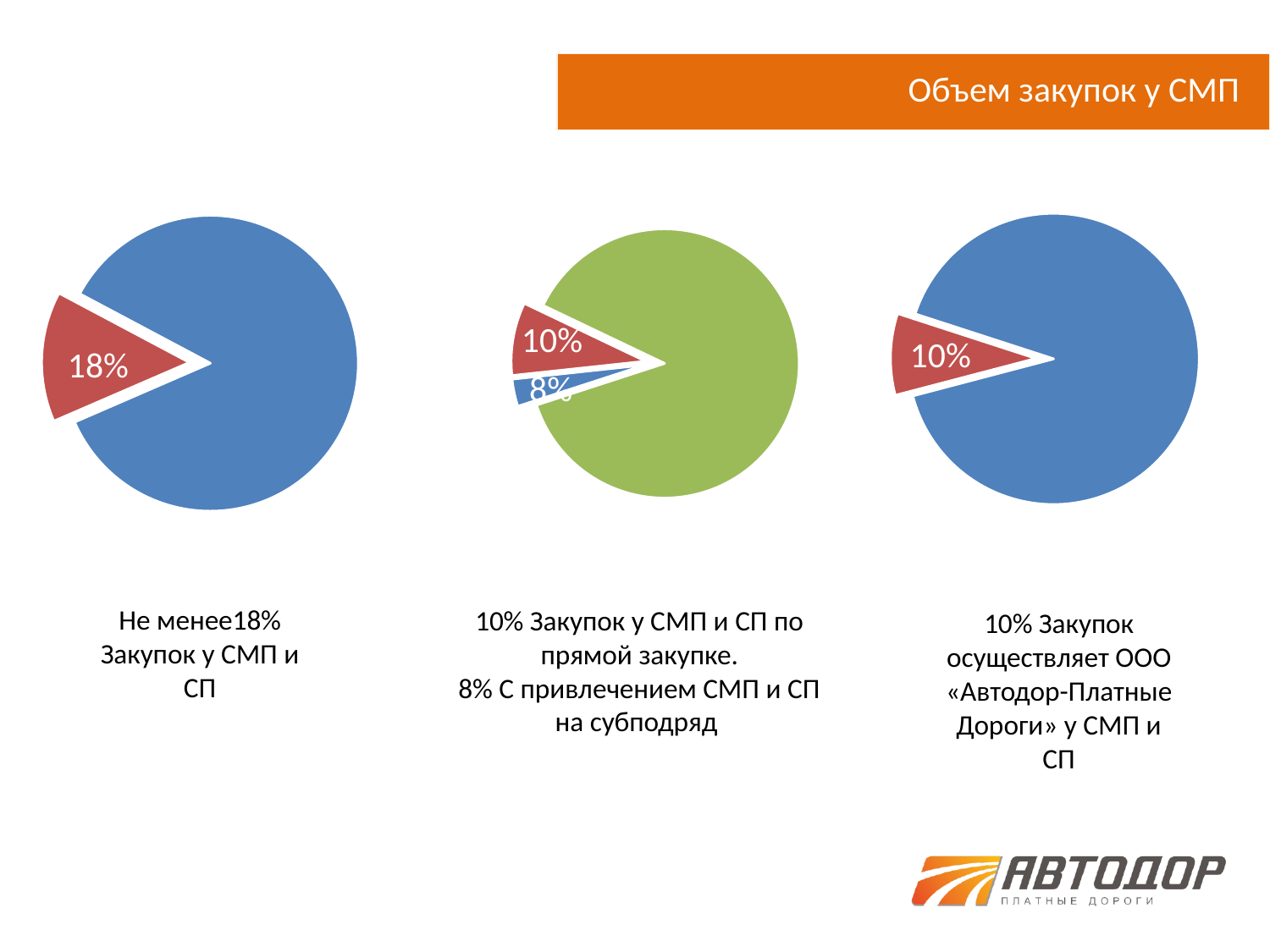
In the middle pie chart, what percentage is shown on the red slice? 10% How many slices does the middle pie chart have? 3 In the middle pie chart, what is the difference between the red slice (10%) and the blue slice (8%)? 2% In the middle pie chart, what is the combined share of the red and blue slices? 18% What kind of chart is the left chart on the slide? pie chart Which of the three pie charts has the largest labelled slice? the left chart (18%) In the right pie chart, what percentage is shown on the red slice? 10% In the middle pie chart, which labelled slice is larger, the red one or the blue one? the red one (10%) In the middle pie chart, what percentage is shown on the blue slice? 8% How many slices does the left pie chart have? 2 What is the title shown in the orange banner at the top of the slide? Объем закупок у СМП In the left pie chart, what percentage is shown on the red slice? 18%